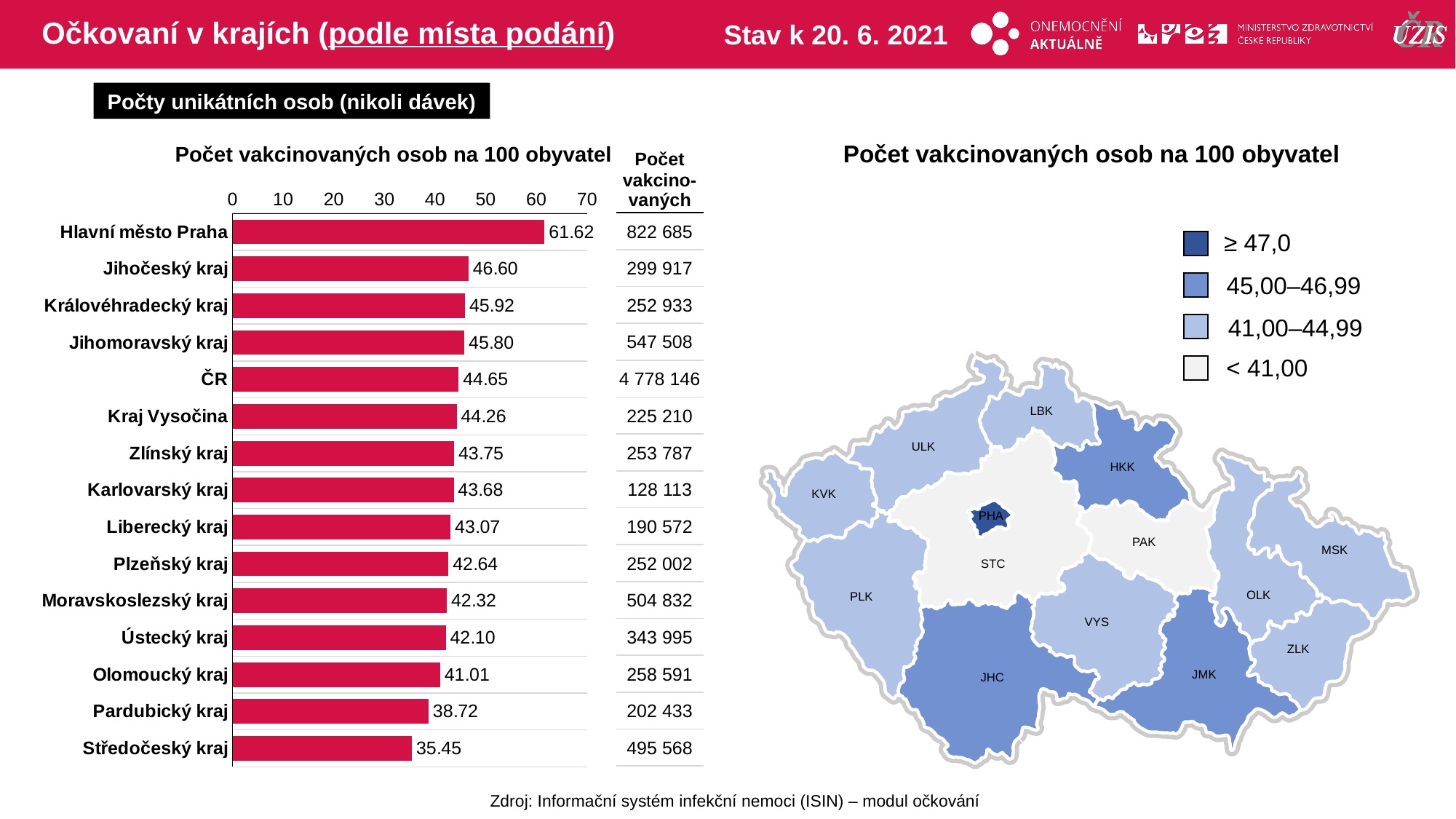
What is the title of the bar chart? Počet vakcinovaných osob na 100 obyvatel In the bar chart, what is the value for ČR? 44.65 In the bar chart, what is the value for Pardubický kraj? 38.72 In the bar chart, which has a larger value: Jihočeský kraj or Plzeňský kraj? Jihočeský kraj In the bar chart, what is the difference between the values for Hlavní město Praha and Středočeský kraj? 26.17 Which category has the lowest value in the bar chart? Středočeský kraj In the bar chart, is the value for Hlavní město Praha greater or less than 60? greater In the bar chart, what is the value for Jihomoravský kraj? 45.80 What type of chart is used to show the number of vaccinated persons per 100 inhabitants by region? bar chart How many bars are shown in the bar chart? 15 Which category has the highest value in the bar chart? Hlavní město Praha In the bar chart, what is the value for Hlavní město Praha? 61.62